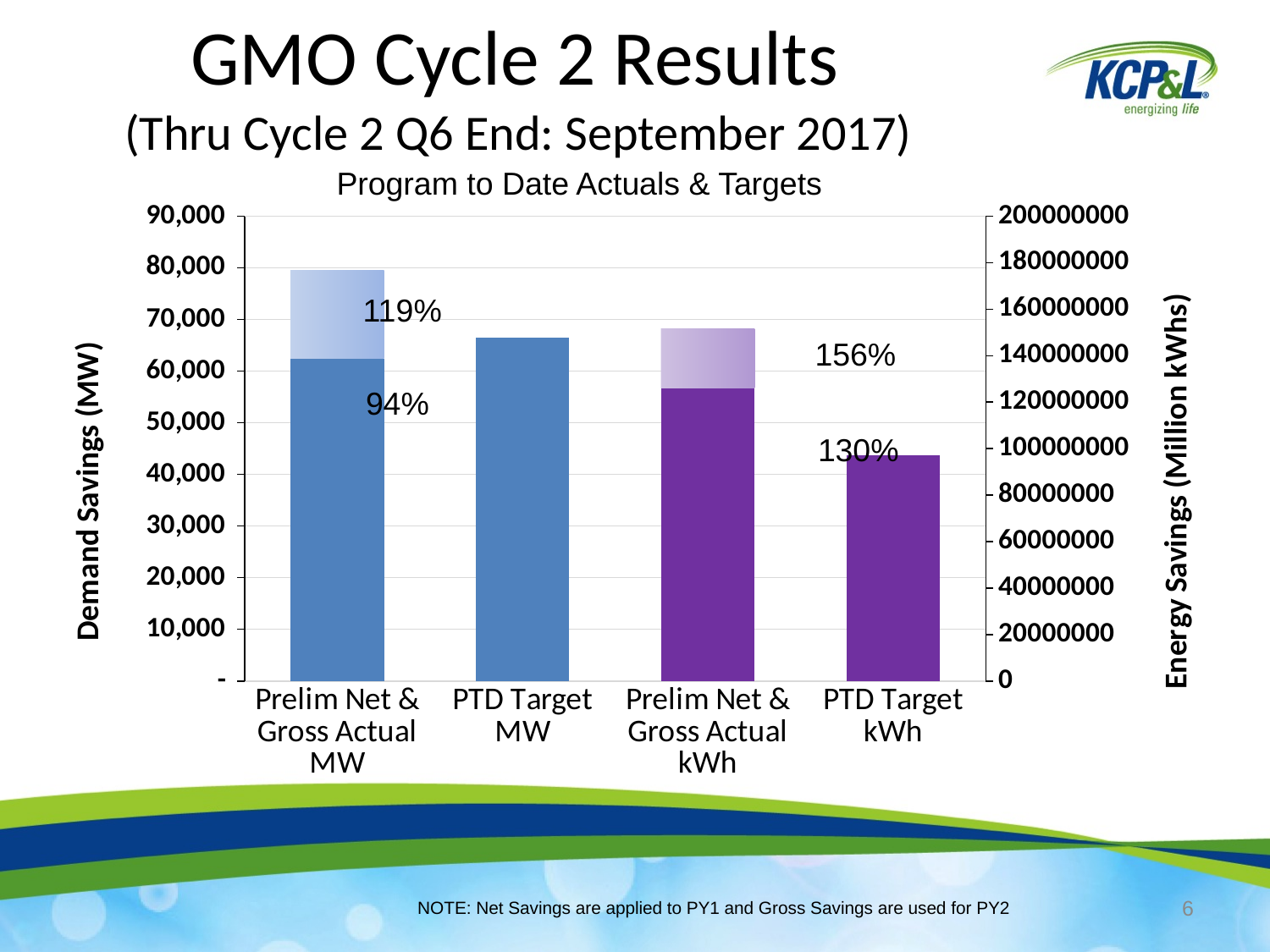
What percentage label is shown at the top of the Prelim Net & Gross Actual MW bar? 119% Which bar is taller: Prelim Net & Gross Actual kWh or PTD Target kWh? Prelim Net & Gross Actual kWh What percentage label is shown on the lower portion of the Prelim Net & Gross Actual MW bar? 94% What is the title of the left vertical axis? Demand Savings (MW) Is the value for PTD Target MW greater or less than 70,000 on the left axis? less What percentage label is shown at the top of the Prelim Net & Gross Actual kWh bar? 156% What is the title of the chart? Program to Date Actuals & Targets Is the total height of the Prelim Net & Gross Actual MW bar greater or less than 70,000 on the left axis? greater Is the value for PTD Target kWh greater or less than 80000000 on the right axis? greater What kind of chart is shown on the slide? bar chart What percentage label is shown on the lower portion of the Prelim Net & Gross Actual kWh bar? 130% How many categories are shown on the x axis of the chart? 4